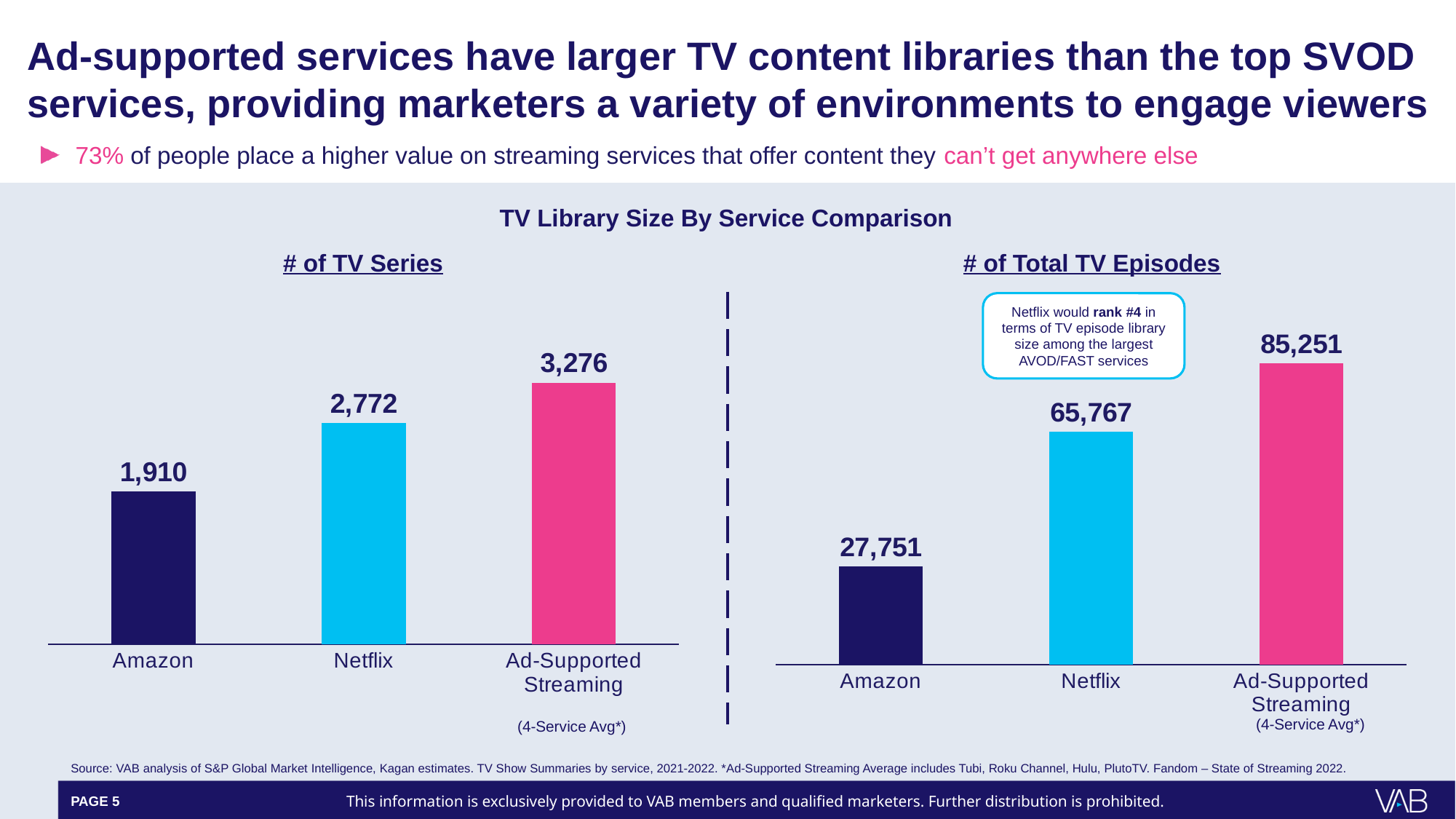
In the '# of Total TV Episodes' chart, what is the value for Amazon? 27,751 In the '# of TV Series' chart, do the values rise or fall from left to right? Rise In the '# of Total TV Episodes' chart, which is larger, Netflix or Amazon? Netflix What kind of chart is the '# of Total TV Episodes' chart? Bar chart In the '# of TV Series' chart, what is the value for Ad-Supported Streaming? 3,276 In the '# of Total TV Episodes' chart, which category has the lowest value? Amazon In the '# of Total TV Episodes' chart, what is the difference between Ad-Supported Streaming and Netflix? 19,484 In the '# of TV Series' chart, what is the value for Netflix? 2,772 How many categories are shown in the '# of TV Series' chart? 3 In the '# of TV Series' chart, which category has the highest value? Ad-Supported Streaming What is the overall title above the two charts? TV Library Size By Service Comparison In the '# of TV Series' chart, what is the difference between Ad-Supported Streaming and Amazon? 1,366